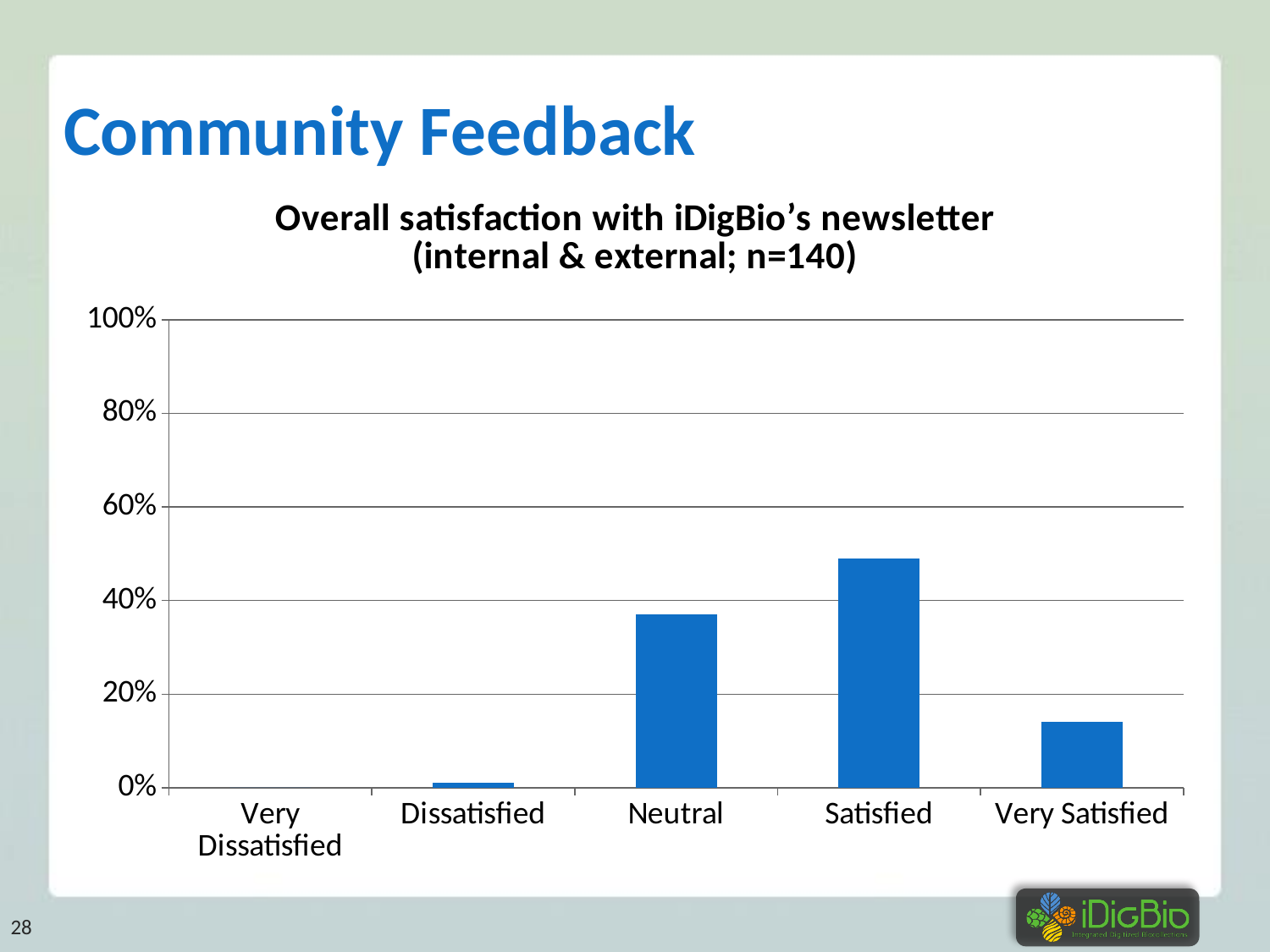
Is the value for Very Satisfied greater or less than 20%? less Is the value for Dissatisfied greater or less than 20%? less What is the highest value shown on the y axis? 100% What kind of chart is shown on the slide? bar chart Which category has the highest value? Satisfied Which is larger, the value for Satisfied or the value for Neutral? Satisfied How many categories are shown on the x axis? 5 Which is larger, the value for Neutral or the value for Very Satisfied? Neutral Is the value for Satisfied greater or less than 40%? greater Which category has the lowest value? Very Dissatisfied What is the title of the chart? Overall satisfaction with iDigBio's newsletter (internal & external; n=140)